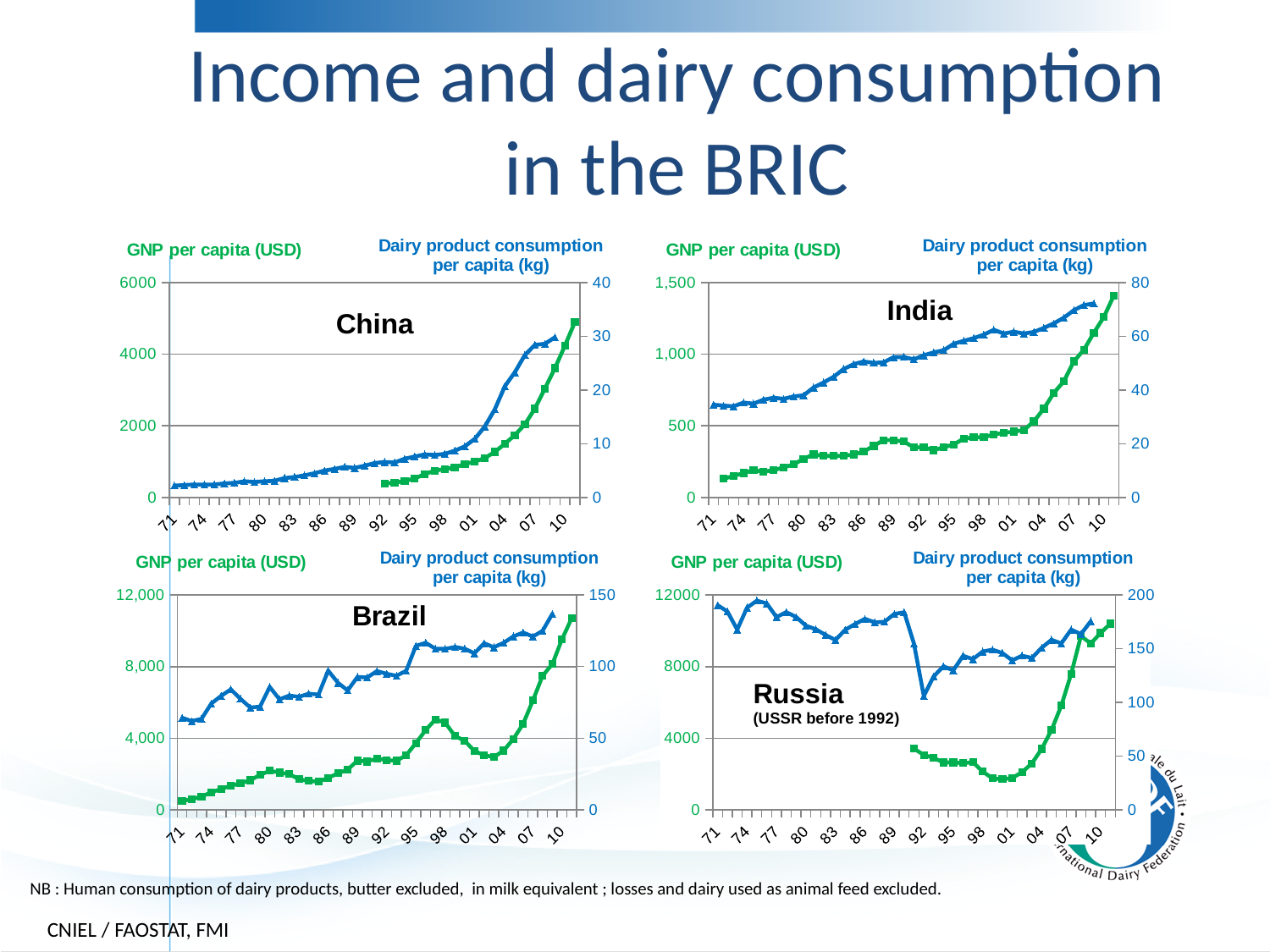
Which colour is used for the GNP per capita (USD) series in the charts? green In the India chart, is dairy product consumption per capita in 1971 greater or less than 40 kg? less How many country charts are shown on the slide? 4 In the India chart, does GNP per capita rise or fall over the period shown? rise In the China chart, is GNP per capita at the end of the series greater or less than 4000 USD? greater Which country's chart carries the note "USSR before 1992"? Russia What kind of chart is used for the China panel? line chart In the Brazil chart, is dairy product consumption per capita at the end of the series greater or less than 100 kg? greater In the China chart, does dairy product consumption per capita rise or fall from 1971 to 2010? rise How many data series are plotted in the India chart? 2